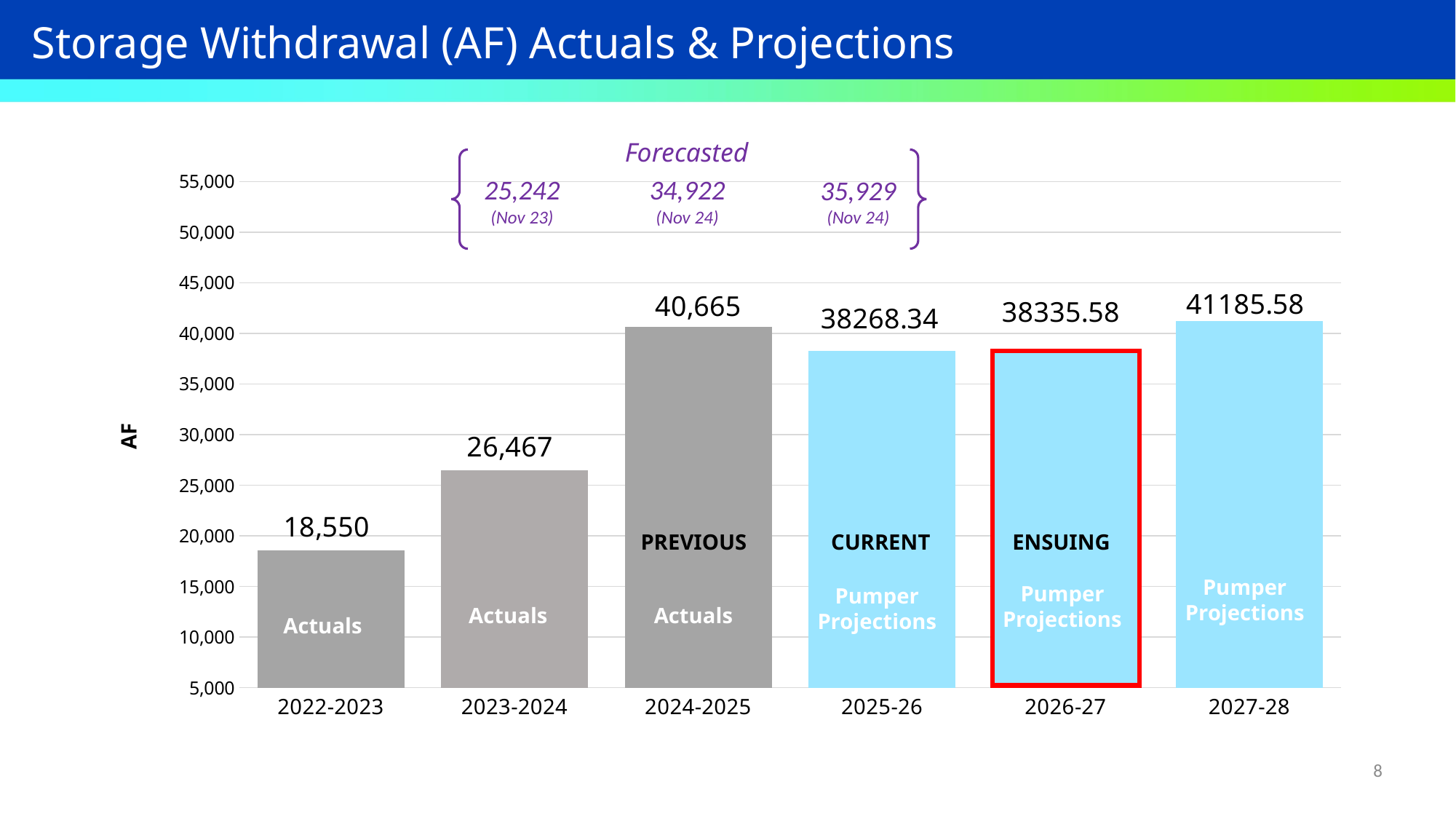
What is the storage withdrawal value for 2022-2023? 18,550 What kind of chart is shown on the slide? Bar chart What is the value shown for 2024-2025? 40,665 How many years are shown on the x axis? 6 Which year's bar is outlined in red? 2026-27 Which year has the highest storage withdrawal value? 2027-28 Which is larger, the value for 2023-2024 or the value for 2024-2025? 2024-2025 What is the difference between the 2023-2024 and 2022-2023 values? 7,917 Which year has the lowest storage withdrawal value? 2022-2023 What is the pumper projection value for 2027-28? 41185.58 What is the value labelled on the 2026-27 bar? 38335.58 Is the value for 2025-26 greater or less than 35,000? greater